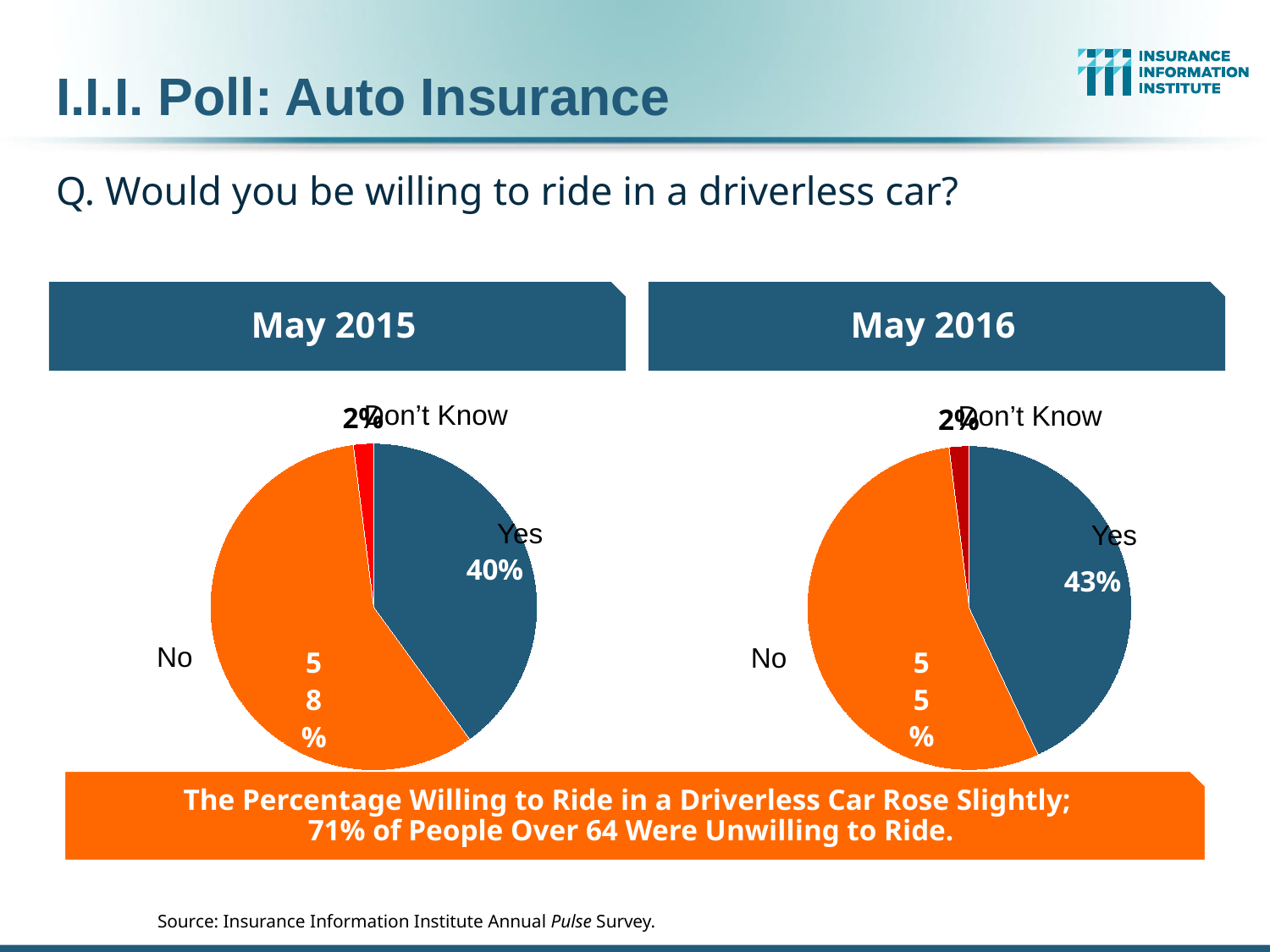
In the May 2015 pie chart, what percentage answered No? 58% In the May 2015 pie chart, which response has the largest slice? No What kind of chart is used for the May 2016 data? Pie chart In the May 2016 pie chart, what percentage answered Yes? 43% In the May 2016 pie chart, which response has the smallest slice? Don't Know In the May 2016 pie chart, what percentage answered No? 55% In the May 2015 pie chart, what percentage answered Yes? 40% What colour is the No slice in the May 2015 pie chart? Orange In the May 2016 pie chart, what percentage answered Don't Know? 2% Which is larger in the May 2016 pie chart, the Yes slice or the No slice? No In the May 2015 pie chart, what is the difference between the No and Yes percentages? 18% How many slices does the May 2015 pie chart have? 3